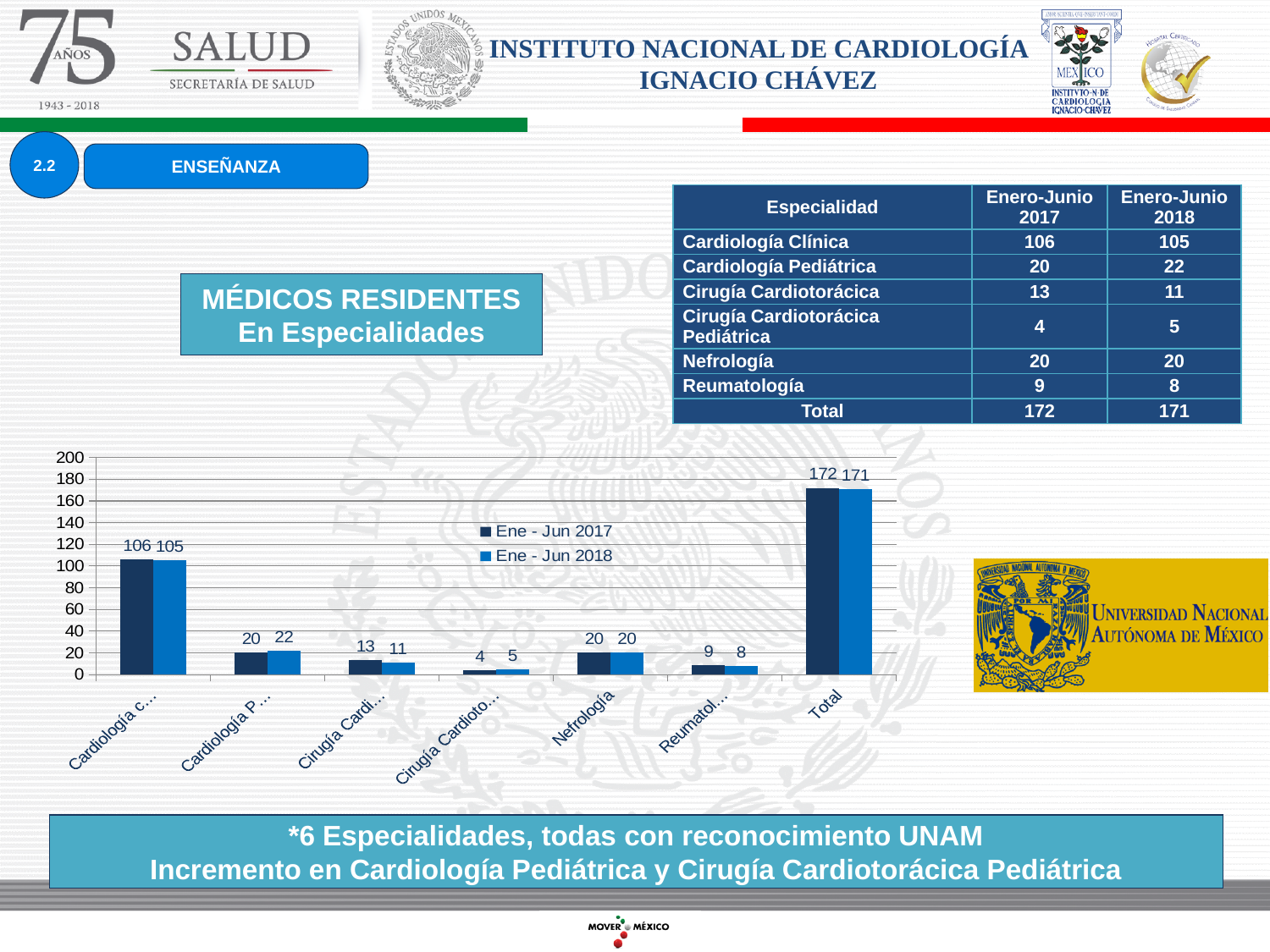
Is the Ene - Jun 2017 value for Cardiología Clínica greater or less than 100? greater What is the Total value for the Ene - Jun 2018 series? 171 What are the two series names listed in the chart legend? Ene - Jun 2017 and Ene - Jun 2018 How many categories are shown along the x axis of the chart? 7 For Reumatología, which series has the larger value, Ene - Jun 2017 or Ene - Jun 2018? Ene - Jun 2017 How many series does the chart legend list? 2 What is the value for Cardiología Pediátrica in the Ene - Jun 2018 series? 22 What is the difference between the Ene - Jun 2017 and Ene - Jun 2018 values for Cirugía Cardiotorácica? 2 Excluding the Total bar, which category has the highest value in the Ene - Jun 2017 series? Cardiología Clínica What is the value for Nefrología in the Ene - Jun 2017 series? 20 Which category has the lowest value in the Ene - Jun 2018 series? Cirugía Cardiotorácica Pediátrica What kind of chart is shown on the slide? bar chart